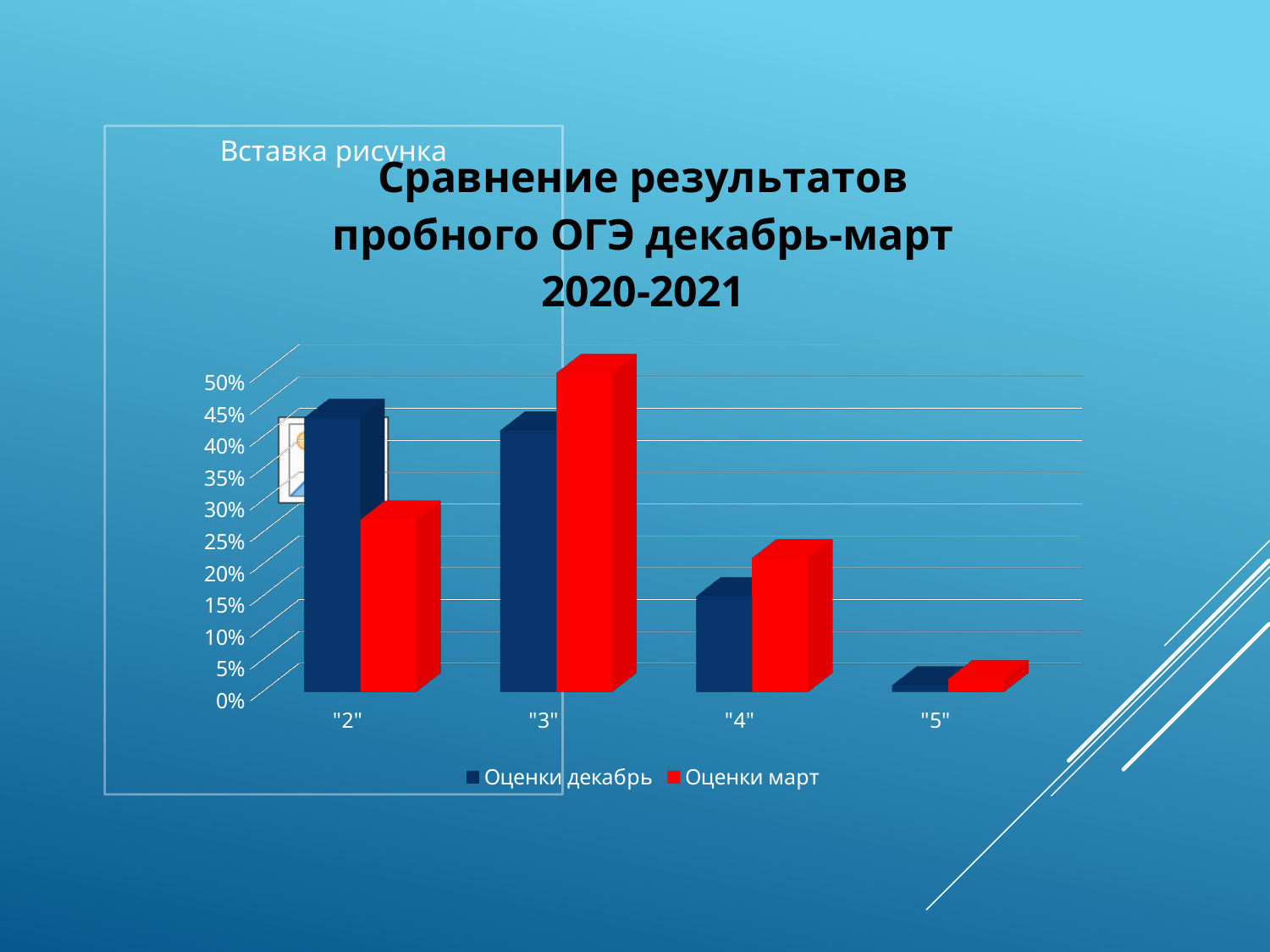
Is the value for Оценки декабрь in category "4" greater or less than 20%? less Which category has the lowest value for Оценки март? "5" Is the value for Оценки март in category "2" greater or less than 35%? less For category "3", which series has the larger value, Оценки декабрь or Оценки март? Оценки март What kind of chart is shown on the slide? bar chart How many categories are shown on the x axis of the chart? 4 Which category has the lowest value for Оценки декабрь? "5" What are the two series named in the legend? Оценки декабрь, Оценки март How many series does the legend list? 2 Is the value for Оценки декабрь in category "2" greater or less than 35%? greater For category "2", which series has the larger value, Оценки декабрь or Оценки март? Оценки декабрь Which category has the highest value for Оценки март? "3"